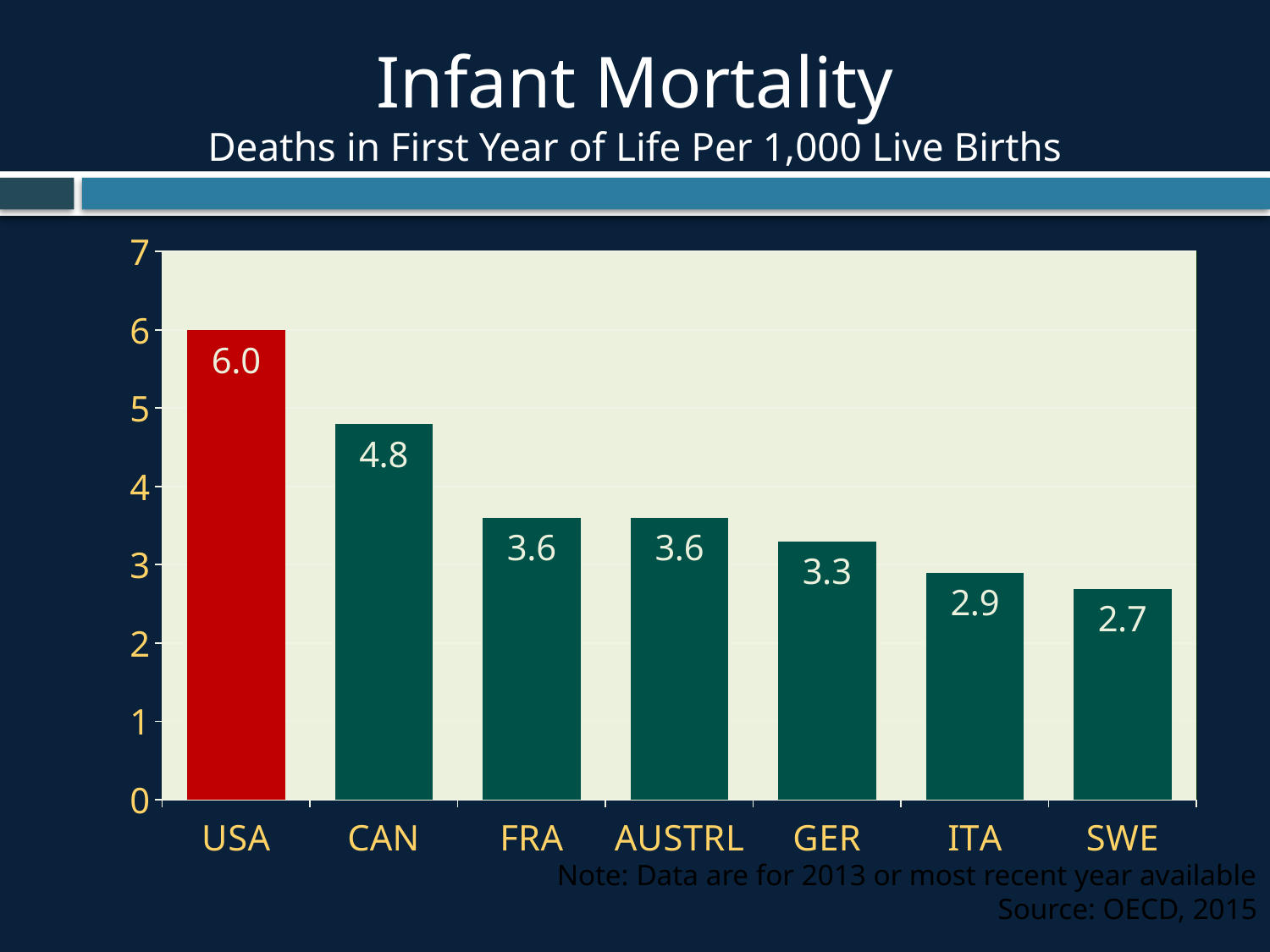
What is the infant mortality value for CAN? 4.8 Which country has the highest infant mortality rate? USA What kind of chart is shown on the slide? Bar chart Which country has the lowest infant mortality rate? SWE What is the infant mortality value for SWE? 2.7 What is the infant mortality value for USA? 6.0 What is the difference between the USA and SWE values? 3.3 Which has a higher infant mortality rate, GER or ITA? GER Which bar is coloured red rather than green? USA What is the infant mortality value for GER? 3.3 How many countries are shown in the chart? 7 What is the difference between the USA and CAN values? 1.2